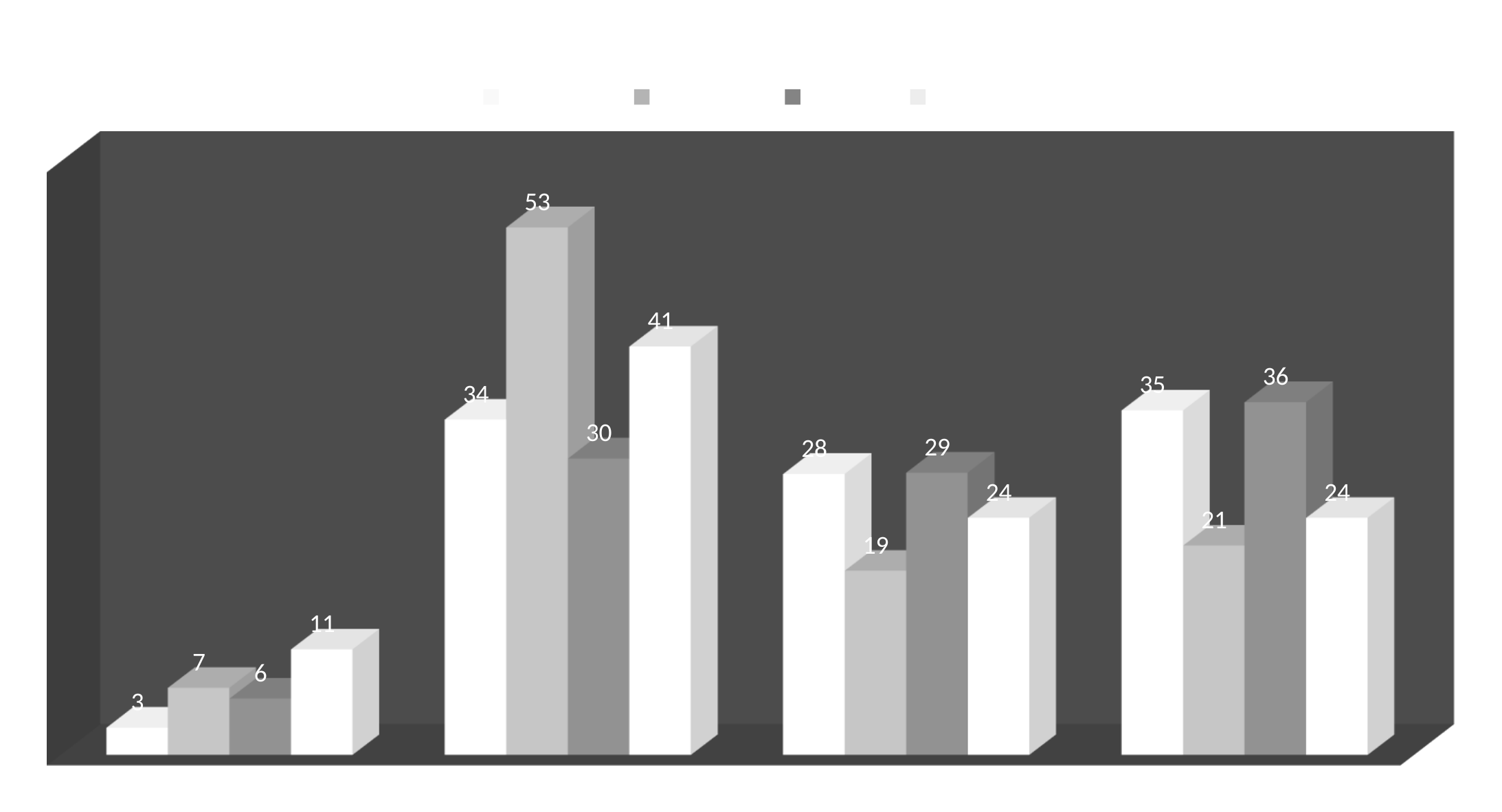
In the fourth group from the left, which is larger: the first bar (35) or the third bar (36)? 36 How many series does the legend show? 4 What is the value of the last (rightmost) bar in the first group from the left? 11 What is the highest value labelled on the chart? 53 What is the difference between the third bar of the fourth group (36) and the second bar of that group (21)? 15 What is the value of the tallest bar in the second group from the left? 53 What is the value of the first (leftmost) bar in the fourth group from the left? 35 What is the lowest value labelled on the chart? 3 How many groups of bars are plotted along the x axis? 4 What is the difference between the tallest bar in the second group (53) and the first bar in that group (34)? 19 What is the value of the second bar in the third group from the left? 19 What kind of chart is shown on the slide? bar chart